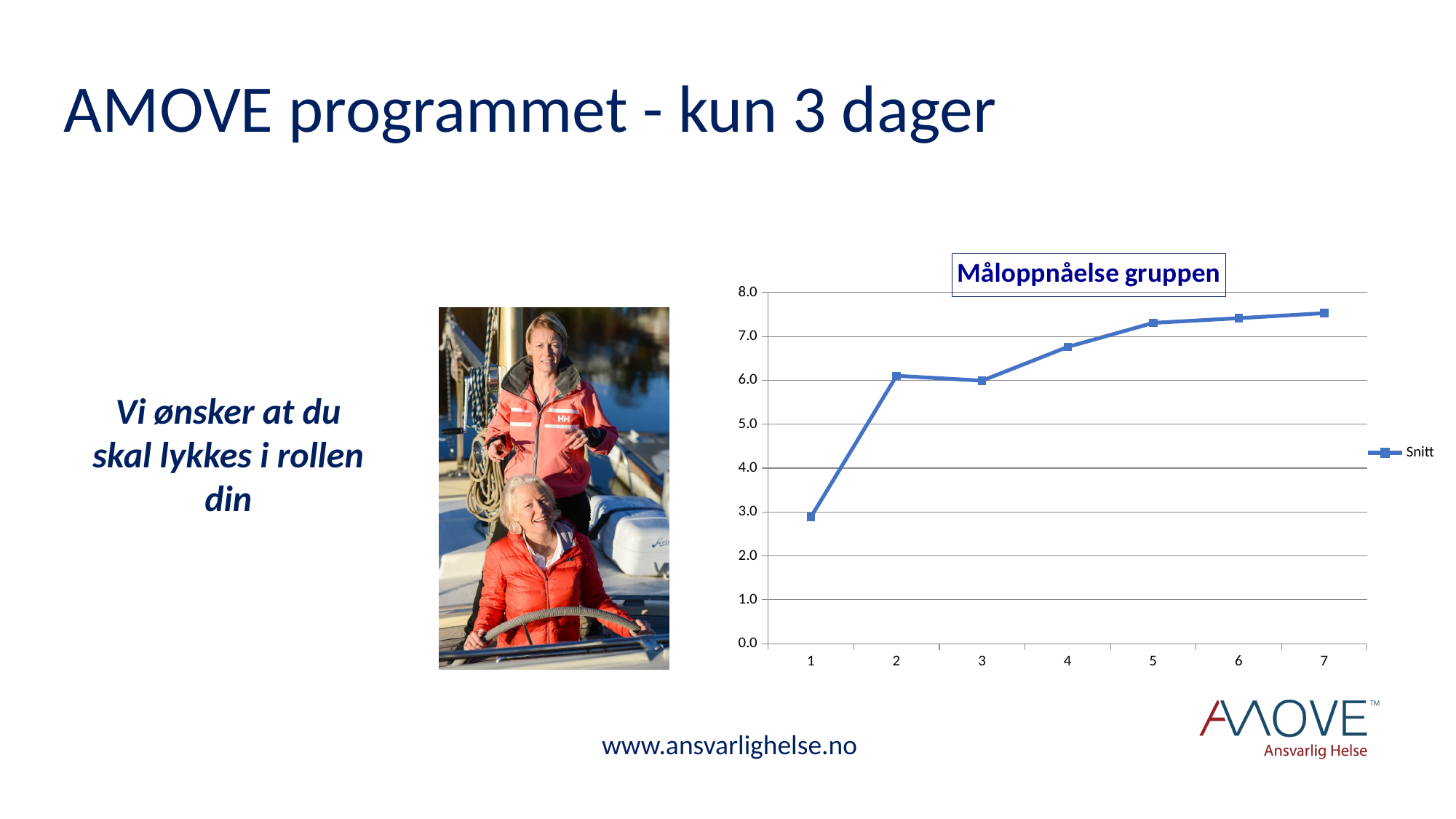
What kind of chart is shown on the slide? line chart Do the values generally rise or fall from category 1 to category 7? rise Is the value at category 2 greater or less than 6.0? greater What is the title of the chart? Måloppnåelse gruppen Which has the larger value, category 1 or category 2? 2 Is the value at category 5 greater or less than 7.0? greater How many series does the legend list? 1 Is the value at category 4 greater or less than 7.0? less How many points are plotted along the x axis? 7 Which x-axis category has the lowest value? 1 What is the name of the series shown in the legend? Snitt